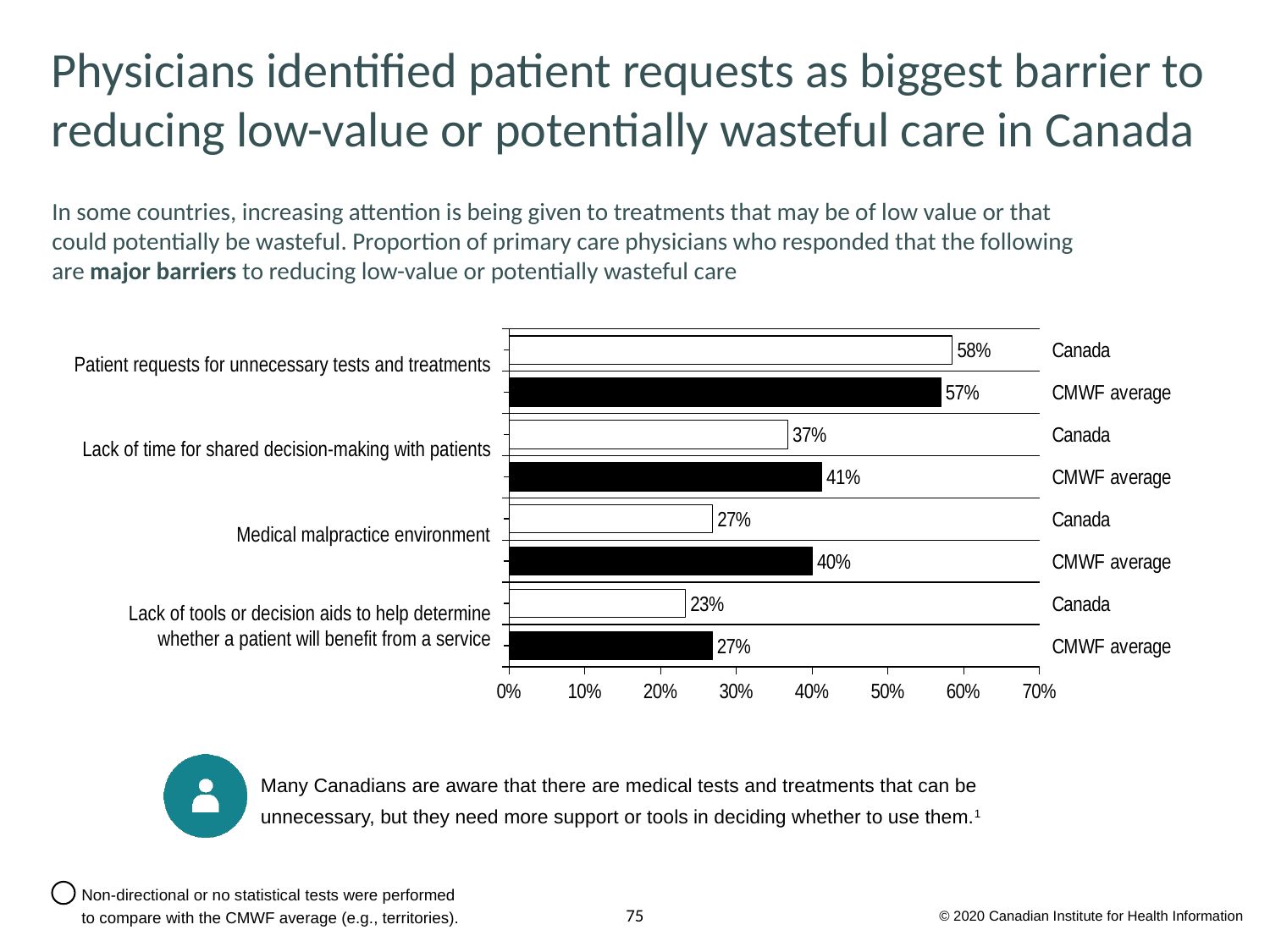
How many barriers are listed on the chart? 4 What is the CMWF average for lack of time for shared decision-making with patients? 41% What is the Canada value for medical malpractice environment? 27% What type of chart is shown on the slide? Bar chart What percentage of Canadian physicians identified patient requests for unnecessary tests and treatments as a major barrier? 58% For lack of time for shared decision-making with patients, which is larger: the Canada value or the CMWF average? CMWF average What is the CMWF average for lack of tools or decision aids to help determine whether a patient will benefit from a service? 27% How many series does the chart show for each barrier? 2 Is the Canada value for patient requests for unnecessary tests and treatments greater or less than 50%? greater Which barrier has the highest Canada value? Patient requests for unnecessary tests and treatments What is the difference between the CMWF average and the Canada value for medical malpractice environment? 13% Which barrier has the lowest Canada value? Lack of tools or decision aids to help determine whether a patient will benefit from a service